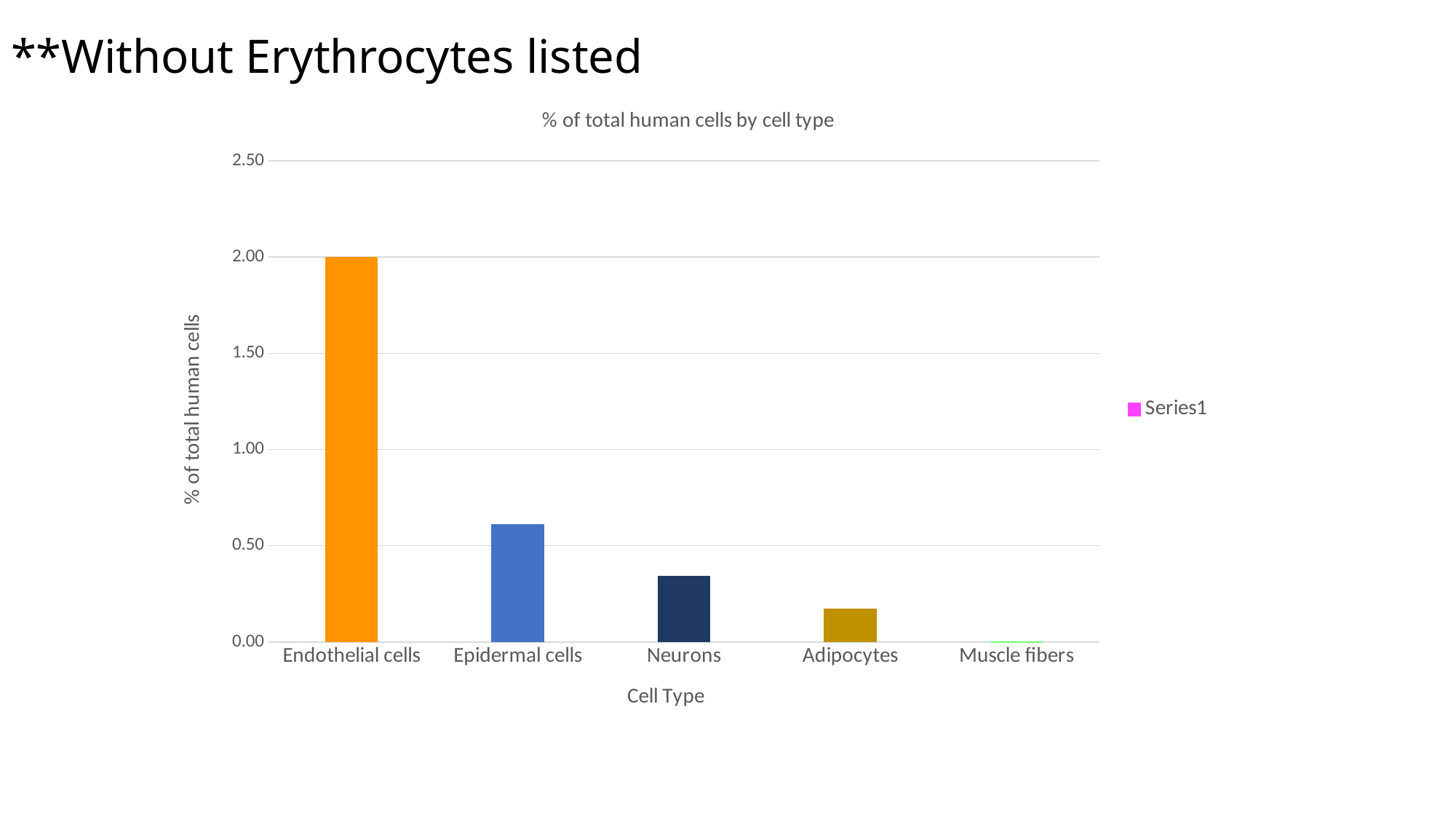
Is the value for Adipocytes greater or less than 0.50? less What type of chart is shown on the slide? bar chart Which cell type has the highest % of total human cells in the chart? Endothelial cells Which cell type has the lowest % of total human cells in the chart? Muscle fibers What is the value for Endothelial cells in the chart? 2.00 Is the value for Neurons greater or less than 0.50? less Do the bar values rise or fall from left to right along the x axis? fall How many series does the chart legend list? 1 How many cell types are shown on the x axis of the chart? 5 Which is larger, the value for Epidermal cells or the value for Neurons? Epidermal cells Is the value for Epidermal cells greater or less than 0.50? greater What is the title of the chart? % of total human cells by cell type